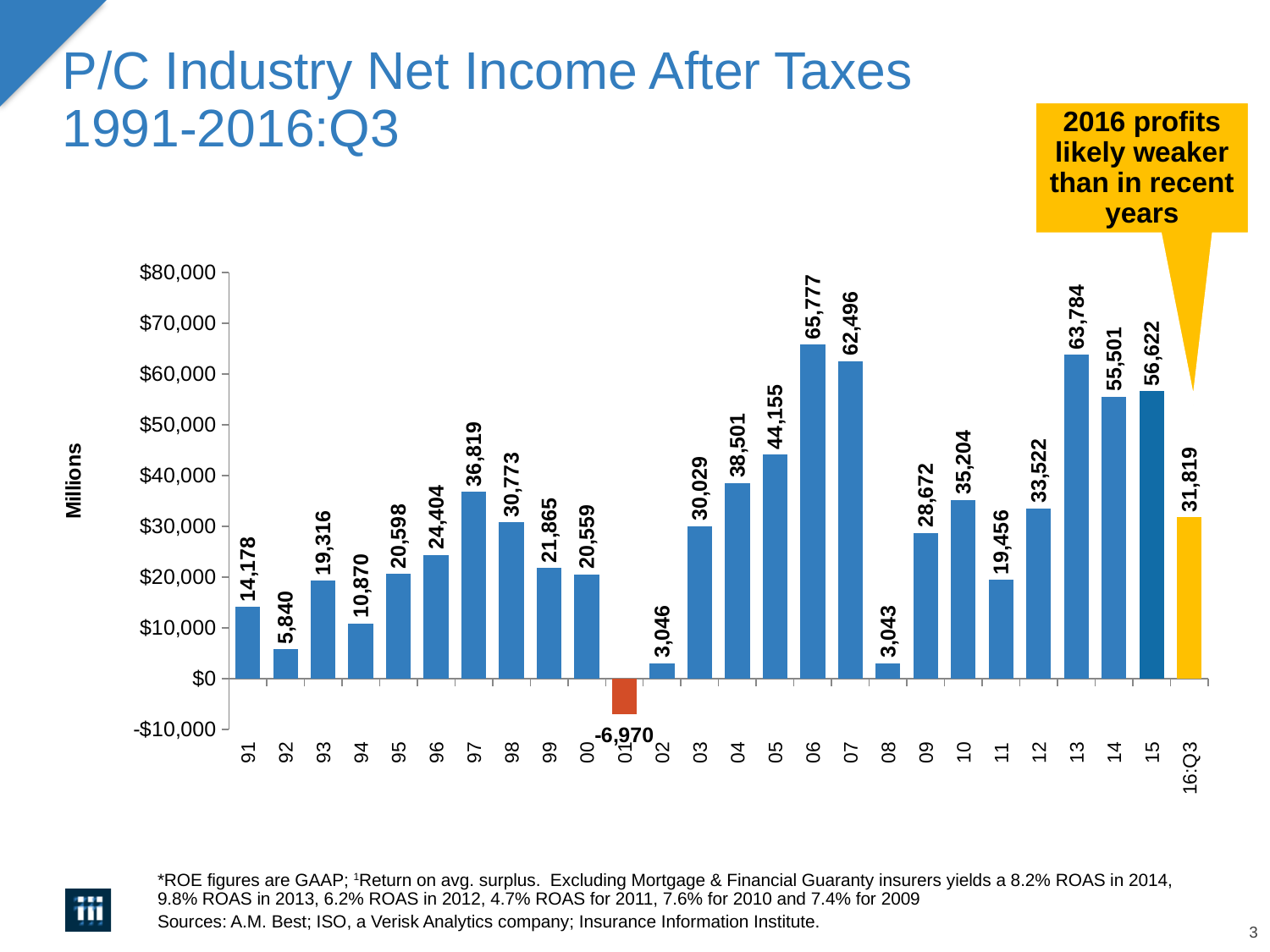
What is the value for 16:Q3? 31,819 What is the value for 2001 (01)? -6,970 How many bars (years/periods) are shown on the chart? 26 What is the label on the vertical axis of the chart? Millions What is the difference between the values for 06 and 07? 3,281 What kind of chart is shown on the slide? bar chart Is the value for 05 greater or less than $40,000? greater What is the value for 2006 (06)? 65,777 What is the difference between the values for 13 and 12? 30,262 Which year has the lowest net income after taxes? 01 Which is larger, the value for 97 or the value for 98? 97 Which year has the highest net income after taxes? 06